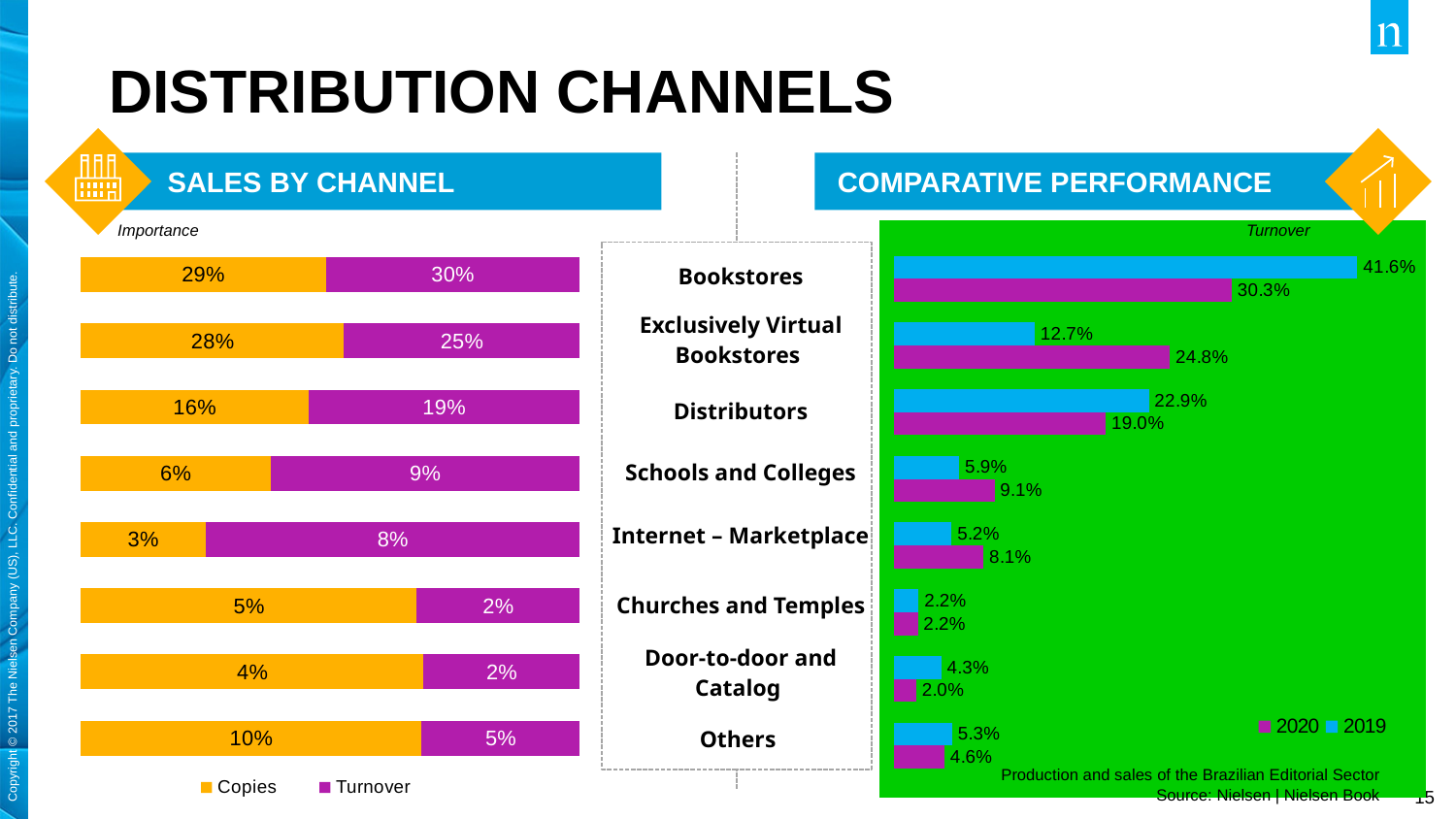
How many series does the legend of the Sales by Channel chart list? 2 In the Comparative Performance chart, what is the 2020 value for Exclusively Virtual Bookstores? 24.8% In the Sales by Channel chart, what is the difference between the Copies and Turnover values for Others? 5% In the Sales by Channel chart, what is the Turnover value for Internet – Marketplace? 8% In the Sales by Channel chart, which channel has the highest Copies value? Bookstores In the Comparative Performance chart, what is the 2019 value for Bookstores? 41.6% In the Comparative Performance chart, what is the difference between the 2019 and 2020 values for Bookstores? 11.3% In the Comparative Performance chart, which channel has the highest 2020 value? Bookstores In the Sales by Channel chart, what is the Copies value for Bookstores? 29% In the Comparative Performance chart, which is larger for Distributors, the 2019 value or the 2020 value? 2019 In the Sales by Channel chart, which channel has the lowest Copies value? Internet – Marketplace How many channels are shown in the Comparative Performance chart? 8